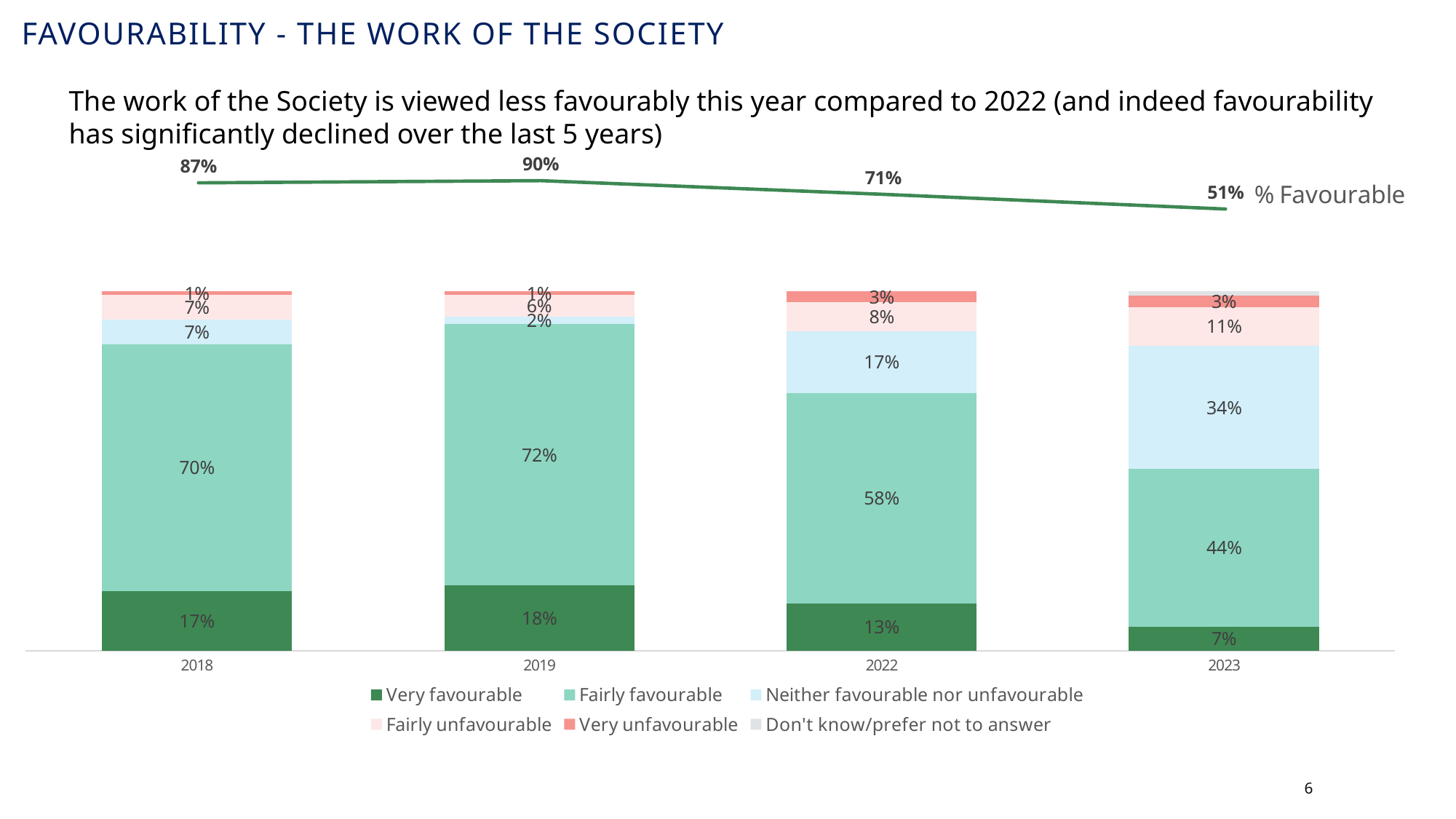
What percentage were 'Neither favourable nor unfavourable' in 2023? 34% Which is larger: the 'Fairly favourable' value in 2022 or in 2023? 2022 How many years are shown on the x axis? 4 In which year was the '% Favourable' line highest? 2019 What was the 'Fairly favourable' value in 2019? 72% In which year was the 'Very favourable' share lowest? 2023 Does the '% Favourable' line rise or fall between 2019 and 2023? Fall How many series does the legend list? 6 What percentage of respondents were 'Very favourable' in 2023? 7% What kind of chart is used to show the favourability breakdown by year? Stacked bar chart What is the '% Favourable' figure shown for 2022? 71% What is the difference between the '% Favourable' values for 2018 and 2023? 36 percentage points